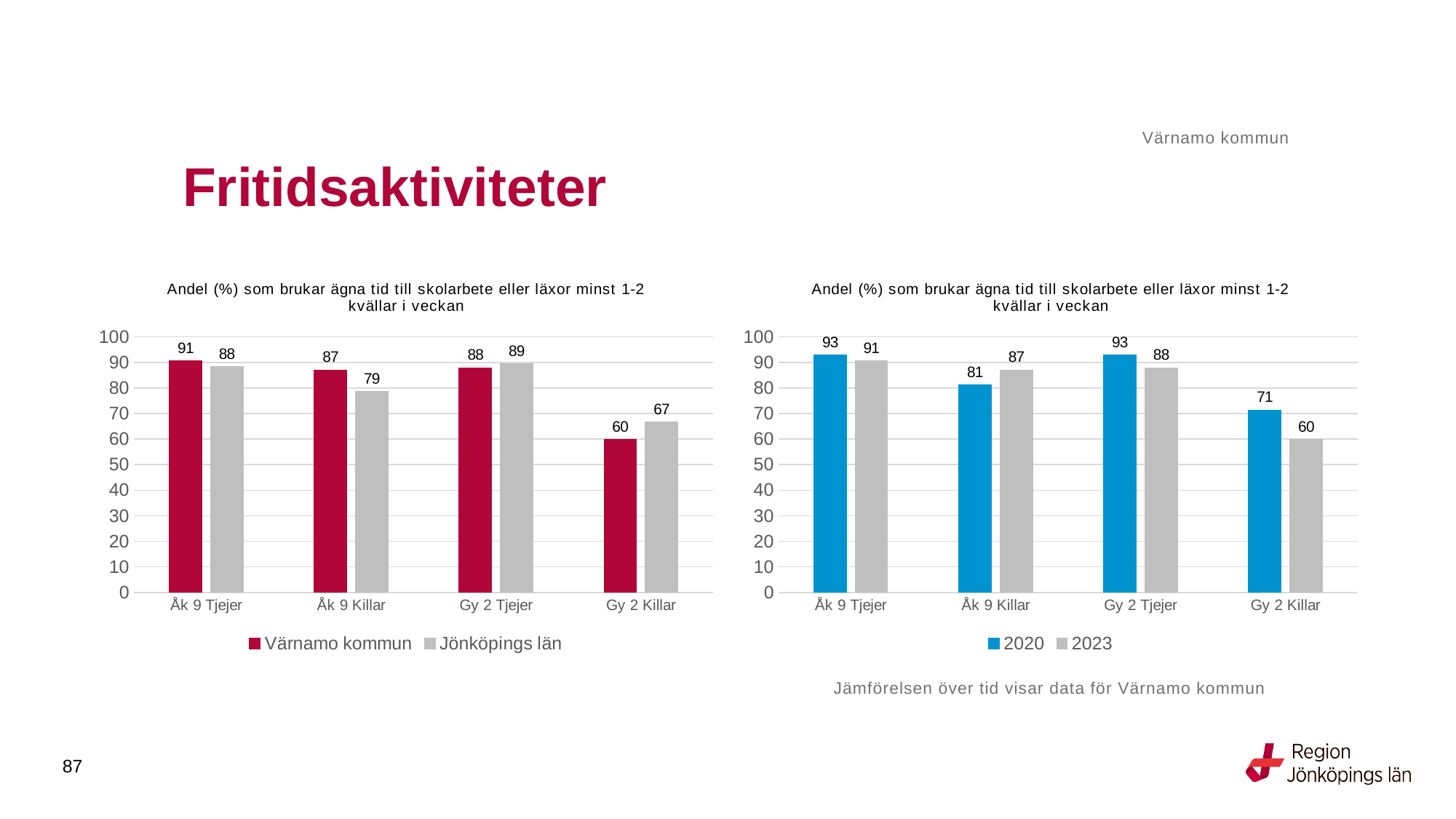
In the right chart, what is the value for 2023 for Åk 9 Killar? 87 In the left chart, what is the value for Värnamo kommun for Åk 9 Tjejer? 91 In the left chart, what is the value for Jönköpings län for Åk 9 Killar? 79 In the right chart, which category has the highest value for 2023? Åk 9 Tjejer In the right chart, what is the difference between 2020 and 2023 for Gy 2 Killar? 11 In the left chart, what is the difference between Jönköpings län and Värnamo kommun for Gy 2 Killar? 7 In the right chart, what is the value for 2020 for Gy 2 Killar? 71 In the left chart, which category has the lowest value for Värnamo kommun? Gy 2 Killar In the left chart, which is larger for Åk 9 Killar: Värnamo kommun or Jönköpings län? Värnamo kommun In the right chart, how many categories are shown on the x axis? 4 In the left chart, how many series does the legend list? 2 What kind of chart is the right chart? Bar chart